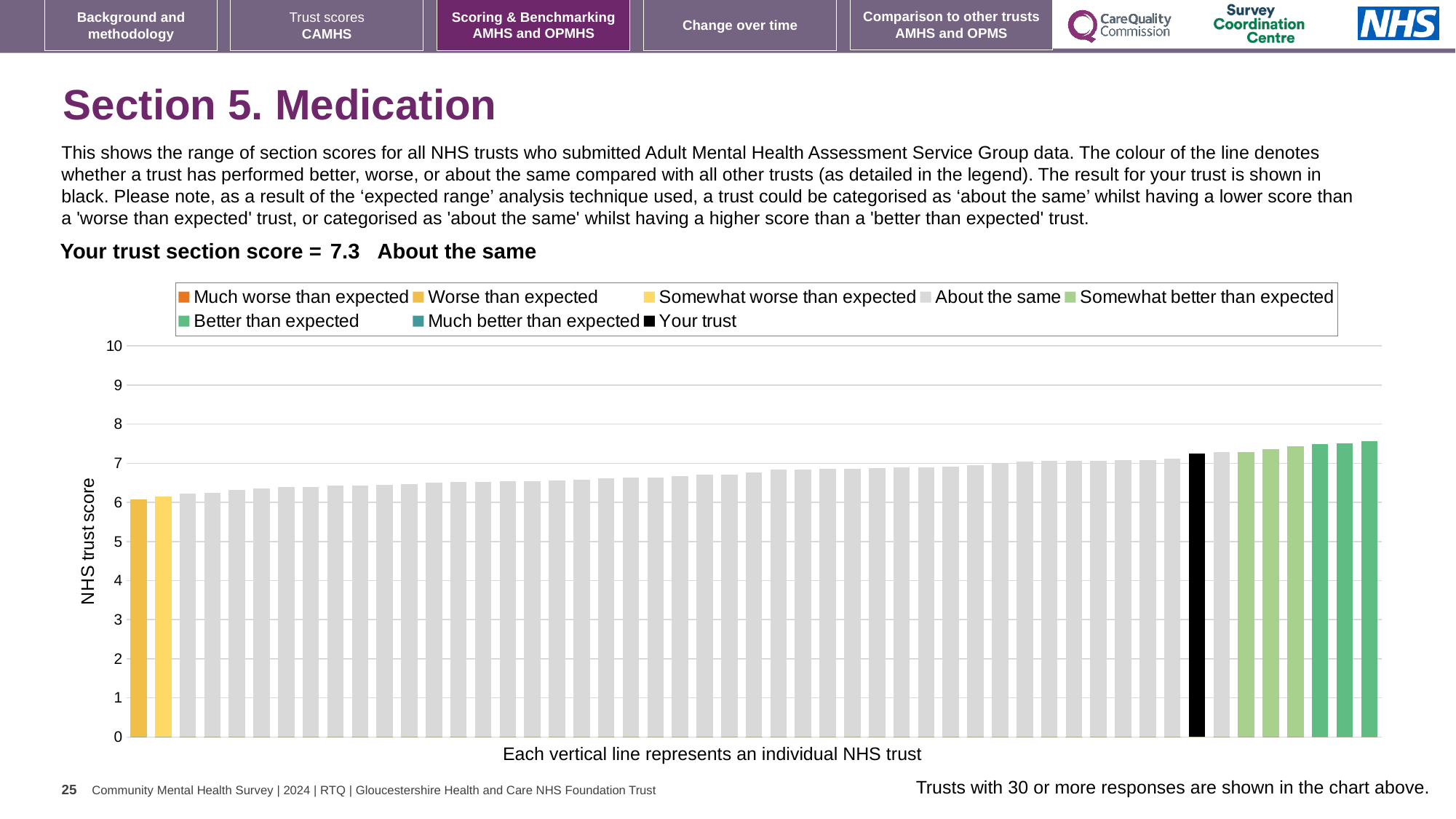
Which is higher, the black bar for your trust or the leftmost bar? the black bar for your trust How many entries does the chart legend list? 8 What colour is the bar representing your trust? black Is the value of the lowest bar in the chart greater or less than 7? less What kind of chart is shown on the slide? bar chart Is the value for your trust (the black bar) greater or less than 7? greater Which legend category does the lowest-scoring trust (leftmost bar) belong to? Worse than expected What is the section score for your trust shown on the slide? 7.3 Do the bar values rise or fall from left to right along the x axis? rise What is the label on the vertical axis of the chart? NHS trust score Is the value of the highest bar in the chart greater or less than 8? less Which category is your trust placed in for this section? About the same